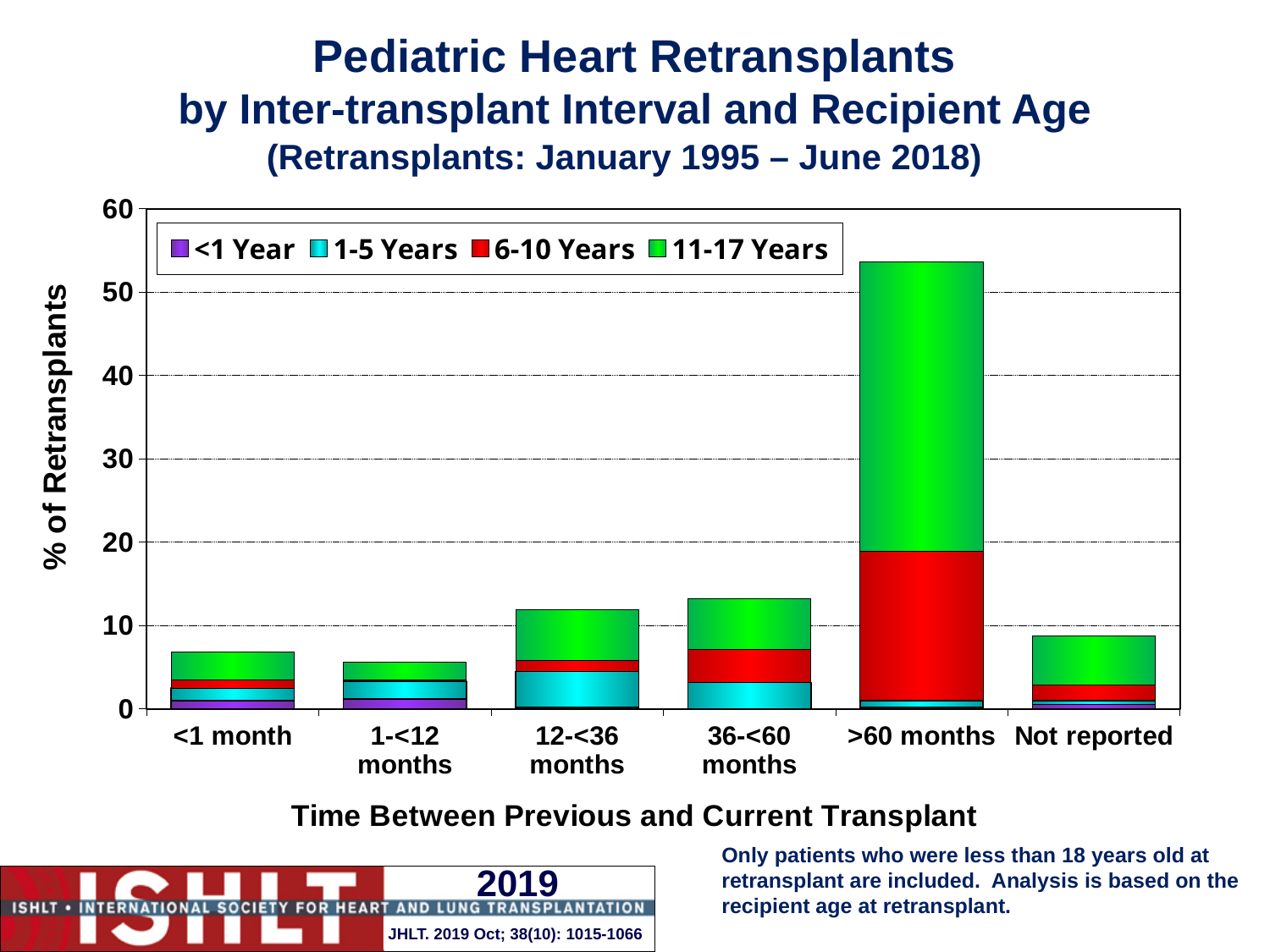
What is the label of the y axis? % of Retransplants Which has a larger total % of retransplants, 12-<36 months or 1-<12 months? 12-<36 months Is the total value for Not reported greater or less than 10? less What kind of chart is shown on the slide? Stacked bar chart How many inter-transplant interval categories are shown on the x axis? 6 Is the total value for 12-<36 months greater or less than 10? greater Which recipient age group is shown in green in the legend? 11-17 Years Is the total value for <1 month greater or less than 10? less Which inter-transplant interval has the highest total % of retransplants? >60 months Which has a larger total % of retransplants, >60 months or 36-<60 months? >60 months How many recipient age groups does the legend list? 4